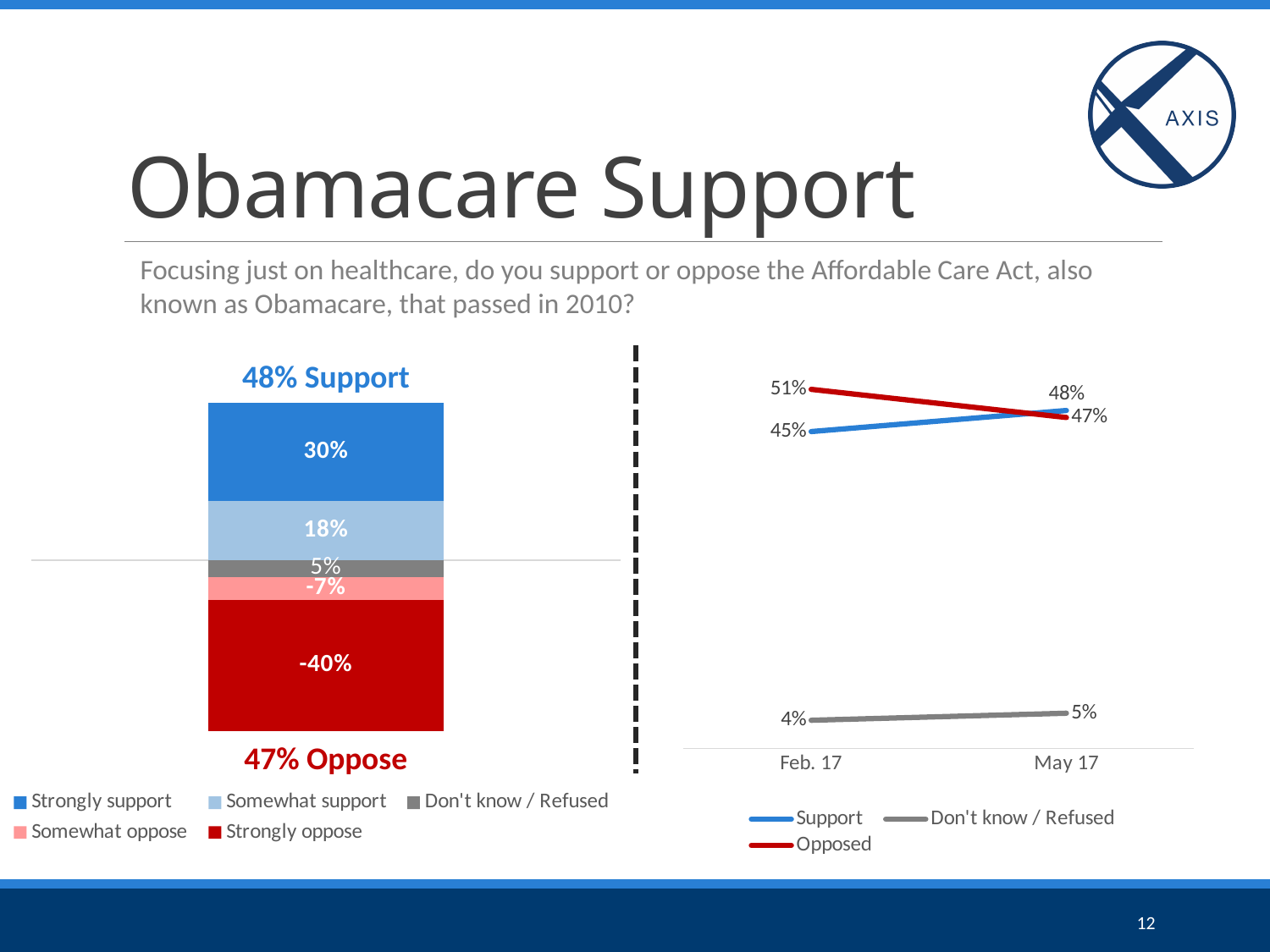
In the stacked bar chart on the left, what total support percentage is shown above the bar? 48% Support In the line chart on the right, what is the value for Support in May 17? 48% In the stacked bar chart on the left, what is the value for Strongly support? 30% In the line chart on the right, what is the difference between Support in May 17 and Support in Feb. 17? 3% In the stacked bar chart on the left, what is the value for Strongly oppose? -40% In the line chart on the right, what is the value for Opposed in Feb. 17? 51% In the line chart on the right, does the Opposed line rise or fall from Feb. 17 to May 17? fall In the line chart on the right, which is larger in Feb. 17: Support or Opposed? Opposed In the line chart on the right, what is the value for Don't know / Refused in Feb. 17? 4% In the stacked bar chart on the left, what is the value for Somewhat support? 18% In the stacked bar chart on the left, what is the value for Don't know / Refused? 5% In the stacked bar chart on the left, how many series does the legend list? 5